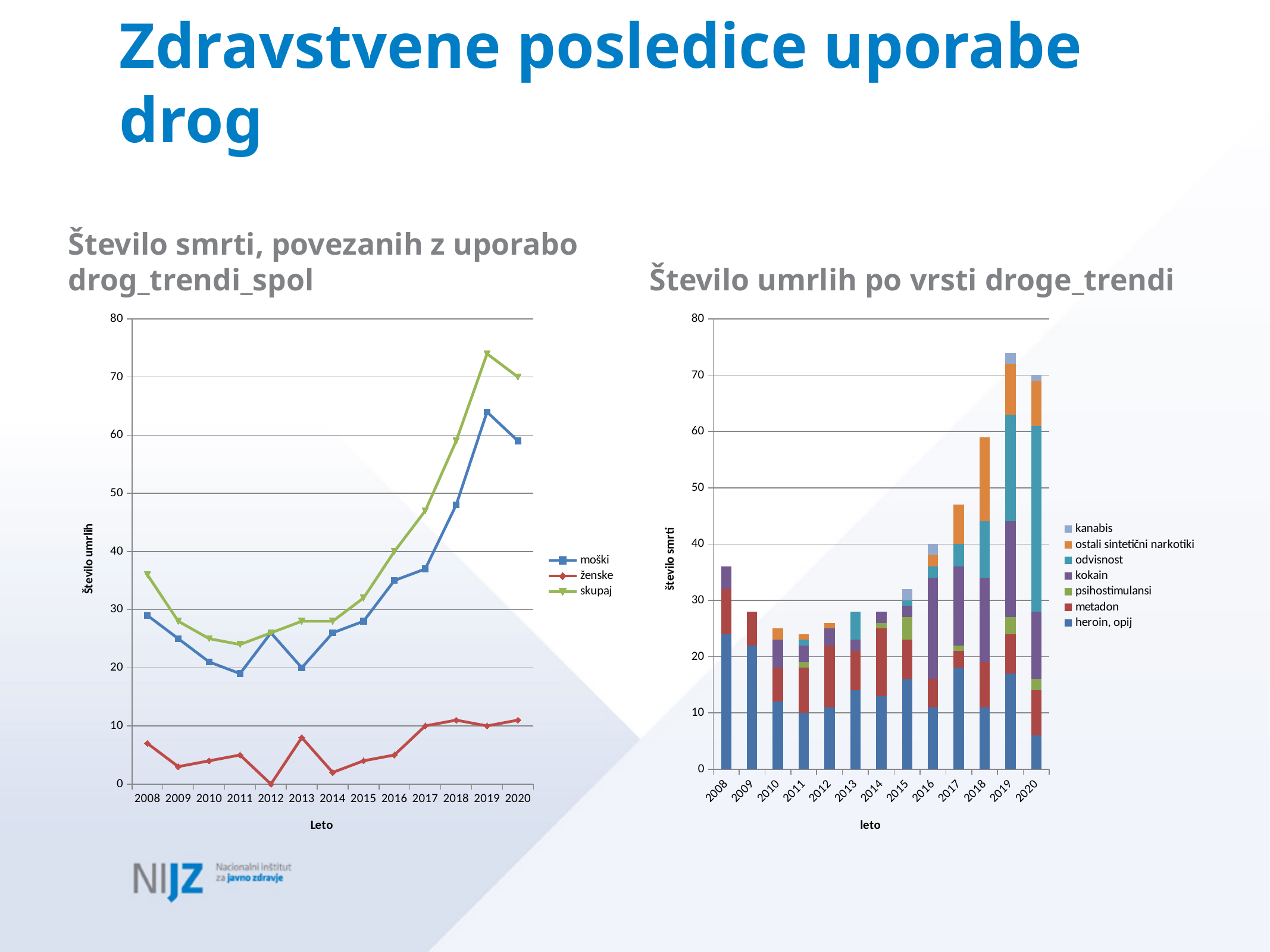
On the right chart (Število umrlih po vrsti droge_trendi), how many series does the legend list? 7 On the left chart (Število smrti, povezanih z uporabo drog_trendi_spol), how many series does the legend list? 3 On the right chart (Število umrlih po vrsti droge_trendi), which year has the tallest stacked bar? 2019 On the right chart (Število umrlih po vrsti droge_trendi), is the total for 2018 greater or less than 50? greater On the left chart (Število smrti, povezanih z uporabo drog_trendi_spol), how many years are shown on the x axis? 13 On the left chart (Število smrti, povezanih z uporabo drog_trendi_spol), is the skupaj value for 2019 greater or less than 70? greater On the left chart (Število smrti, povezanih z uporabo drog_trendi_spol), is the moški value for 2019 greater or less than 60? greater On the left chart (Število smrti, povezanih z uporabo drog_trendi_spol), which series has the larger value in 2019, moški or ženske? moški What kind of chart is the right chart (Število umrlih po vrsti droge_trendi)? stacked bar chart On the left chart (Število smrti, povezanih z uporabo drog_trendi_spol), in which year is the ženske series at its lowest? 2012 On the left chart (Število smrti, povezanih z uporabo drog_trendi_spol), in which year does the skupaj series reach its highest value? 2019 On the left chart (Število smrti, povezanih z uporabo drog_trendi_spol), does the skupaj series rise or fall between 2015 and 2019? rise